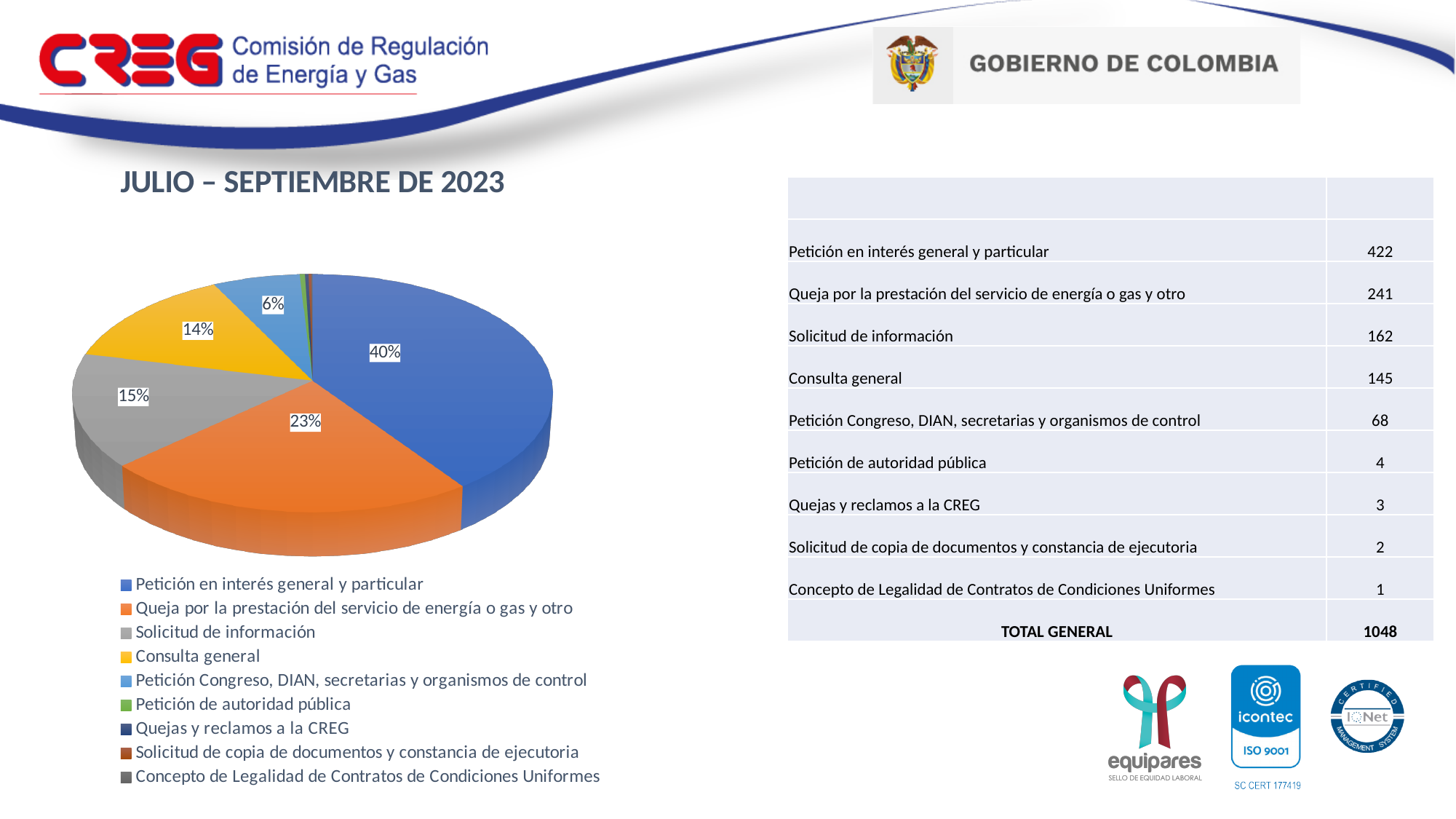
Which category has the largest slice of the pie? Petición en interés general y particular What colour is the slice for "Consulta general" in the pie chart? Yellow What period does the title above the pie chart refer to? JULIO – SEPTIEMBRE DE 2023 What share of the pie does "Consulta general" represent? 14% What share of the pie does "Queja por la prestación del servicio de energía o gas y otro" represent? 23% How many categories does the pie chart's legend list? 9 What share of the pie does "Petición en interés general y particular" represent? 40% What kind of chart is shown on the slide? Pie chart What is the difference in percentage points between the slices for "Petición en interés general y particular" and "Queja por la prestación del servicio de energía o gas y otro"? 17 percentage points Which slice is larger: "Solicitud de información" or "Petición Congreso, DIAN, secretarias y organismos de control"? Solicitud de información